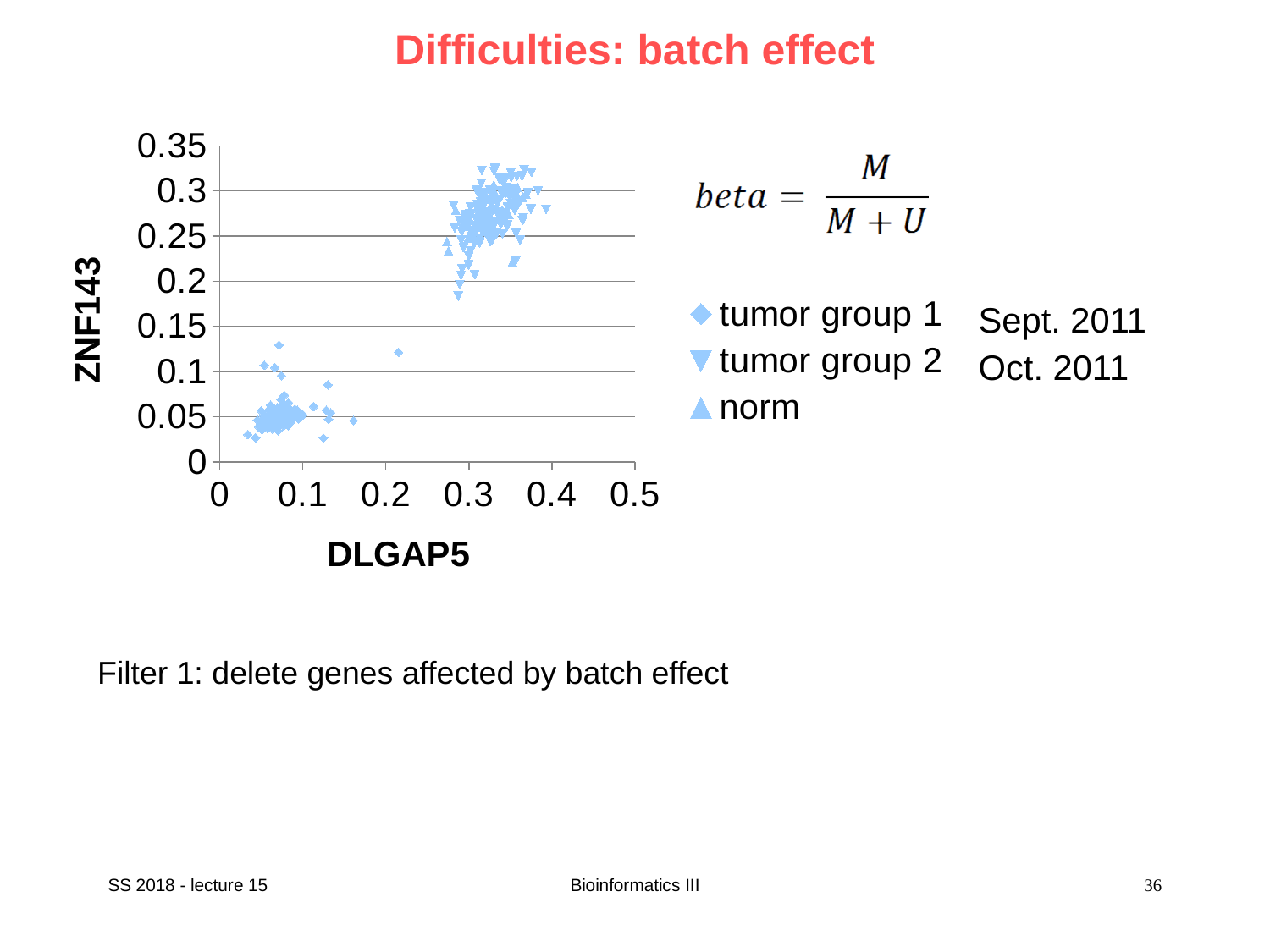
What kind of chart is shown on the slide? scatter plot Are the DLGAP5 values of the tumor group 1 points greater or less than 0.25? less Which series has higher ZNF143 values, tumor group 1 or tumor group 2? tumor group 2 What is the label of the x axis? DLGAP5 How many series does the legend list? 3 Which series has lower DLGAP5 values, tumor group 1 or tumor group 2? tumor group 1 Are the ZNF143 values of the tumor group 1 points greater or less than 0.15? less What is the label of the y axis? ZNF143